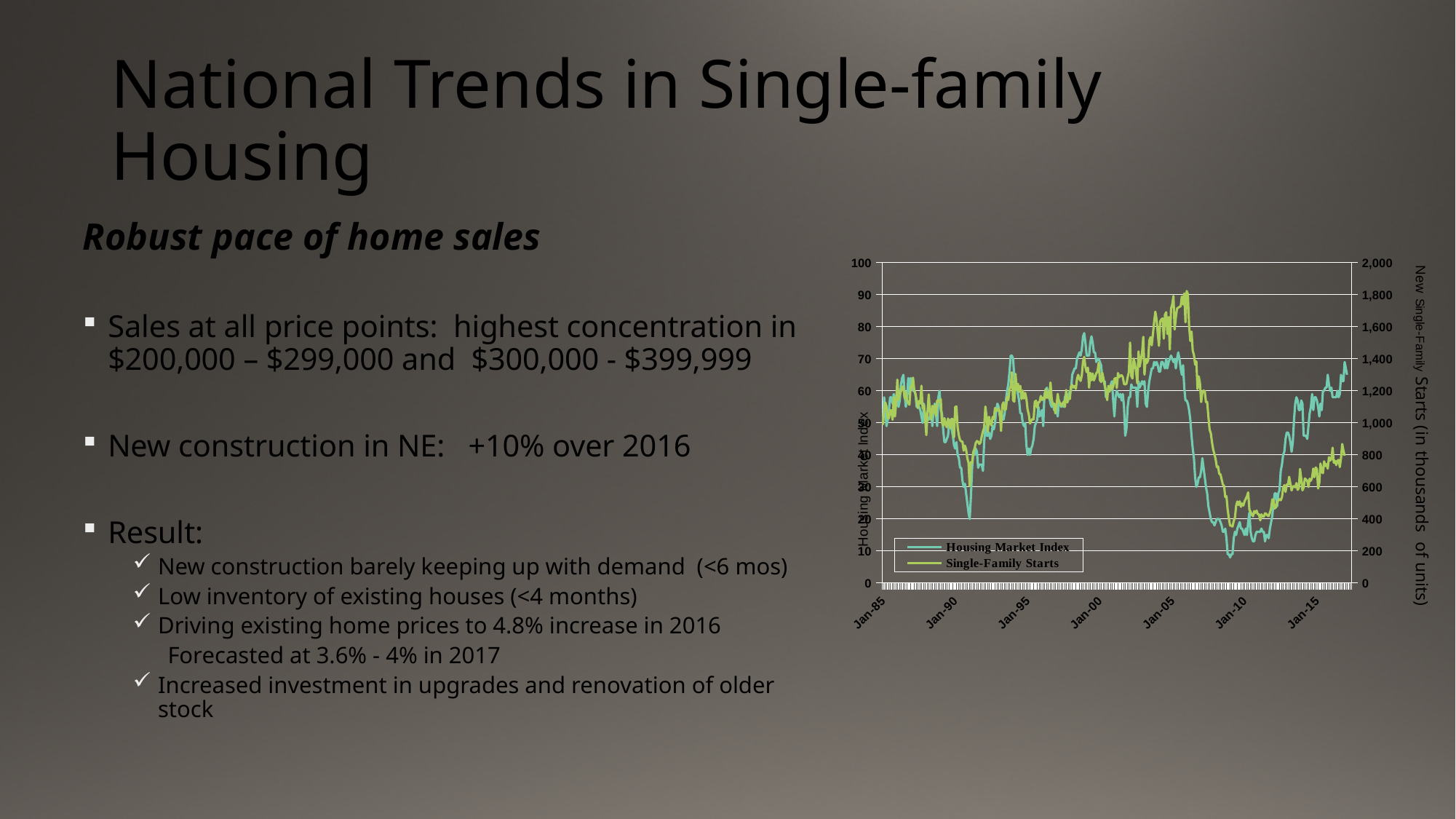
Does the Housing Market Index rise or fall between Jan-05 and Jan-10? fall What is the label of the chart's right-hand vertical axis? New Single-Family Starts (in thousands of units) How many year labels are shown on the chart's x axis? 7 Is the Housing Market Index around Jan-05 greater or less than 60? greater Is the Housing Market Index at the right end of the chart (after Jan-15) greater or less than 60? greater Is the peak of Single-Family Starts around 2005-2006 greater or less than 1,600 on the right axis? greater Do Single-Family Starts rise or fall between Jan-10 and Jan-15? rise What kind of chart is shown on the slide? line chart How many series does the chart's legend list? 2 What are the two series named in the chart's legend? Housing Market Index and Single-Family Starts